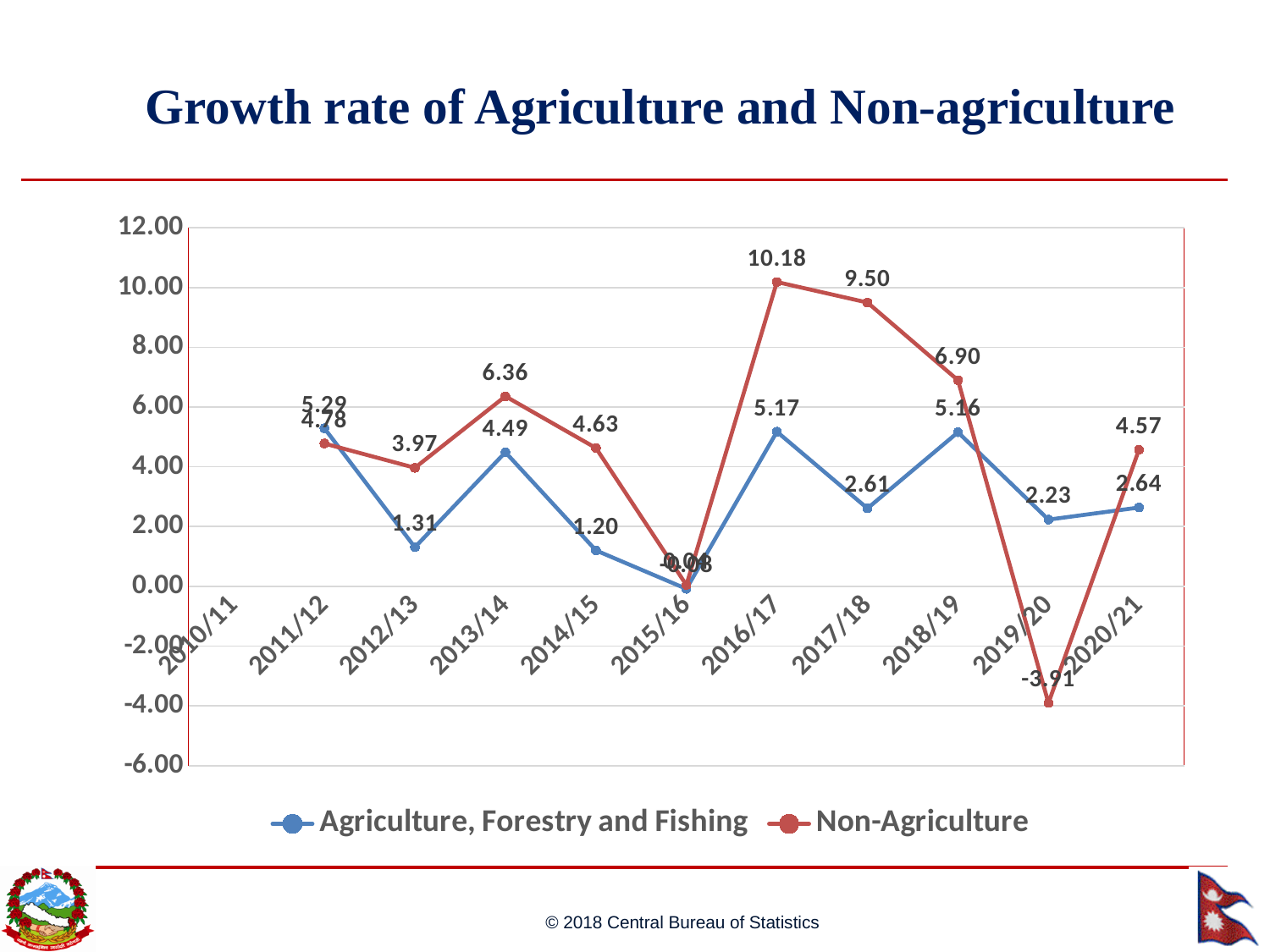
How many series does the legend list? 2 Does the Non-Agriculture growth rate rise or fall from 2016/17 to 2019/20? Fall In which year does the Non-Agriculture series reach its highest value? 2016/17 What is the Non-Agriculture growth rate in 2019/20? -3.91 Is the Non-Agriculture value for 2017/18 greater or less than 8.00? greater In which year is the Non-Agriculture growth rate lowest? 2019/20 What is the Non-Agriculture growth rate for 2016/17? 10.18 What is the difference between the Non-Agriculture and Agriculture, Forestry and Fishing growth rates in 2016/17? 5.01 What is the growth rate of Agriculture, Forestry and Fishing in 2017/18? 2.61 What kind of chart is shown on the slide? Line chart Which series has the higher growth rate in 2013/14? Non-Agriculture What is the Agriculture, Forestry and Fishing growth rate in 2020/21? 2.64